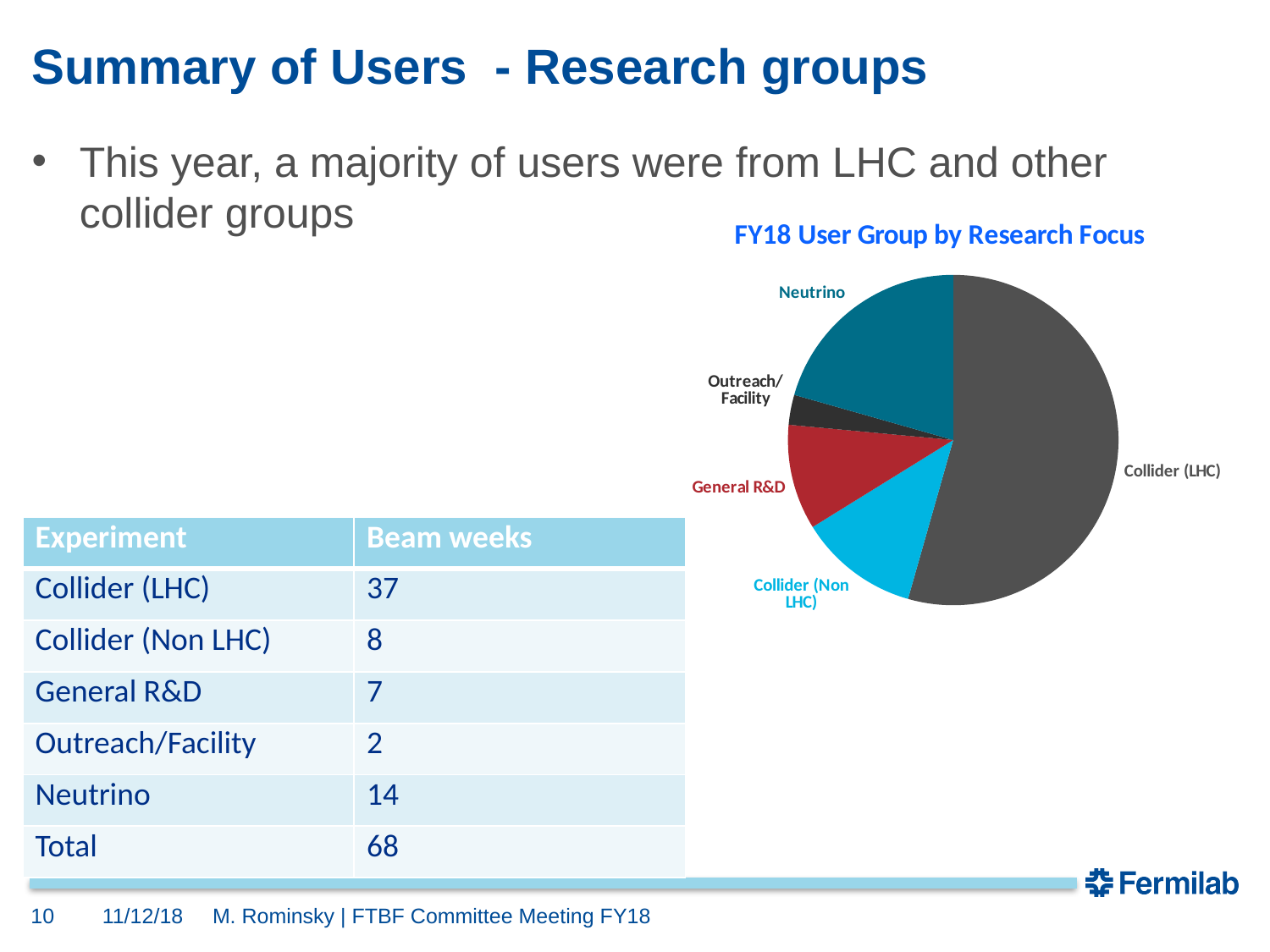
According to the table beside the pie chart, what is the total number of beam weeks? 68 How many slices does the pie chart have? 5 Which slice is larger in the pie chart, Neutrino or General R&D? Neutrino Which research group has the smallest slice of the pie chart? Outreach/Facility Which slice of the pie chart is coloured red? General R&D Which research group has the largest slice of the pie chart? Collider (LHC) According to the table beside the pie chart, how many beam weeks does Collider (LHC) have? 37 What type of chart is shown on the slide? pie chart According to the table beside the pie chart, how many beam weeks does Neutrino have? 14 Using the table beside the pie chart, what is the difference in beam weeks between Collider (LHC) and Neutrino? 23 What is the title of the pie chart? FY18 User Group by Research Focus Which slice is larger in the pie chart, Collider (Non LHC) or Outreach/Facility? Collider (Non LHC)